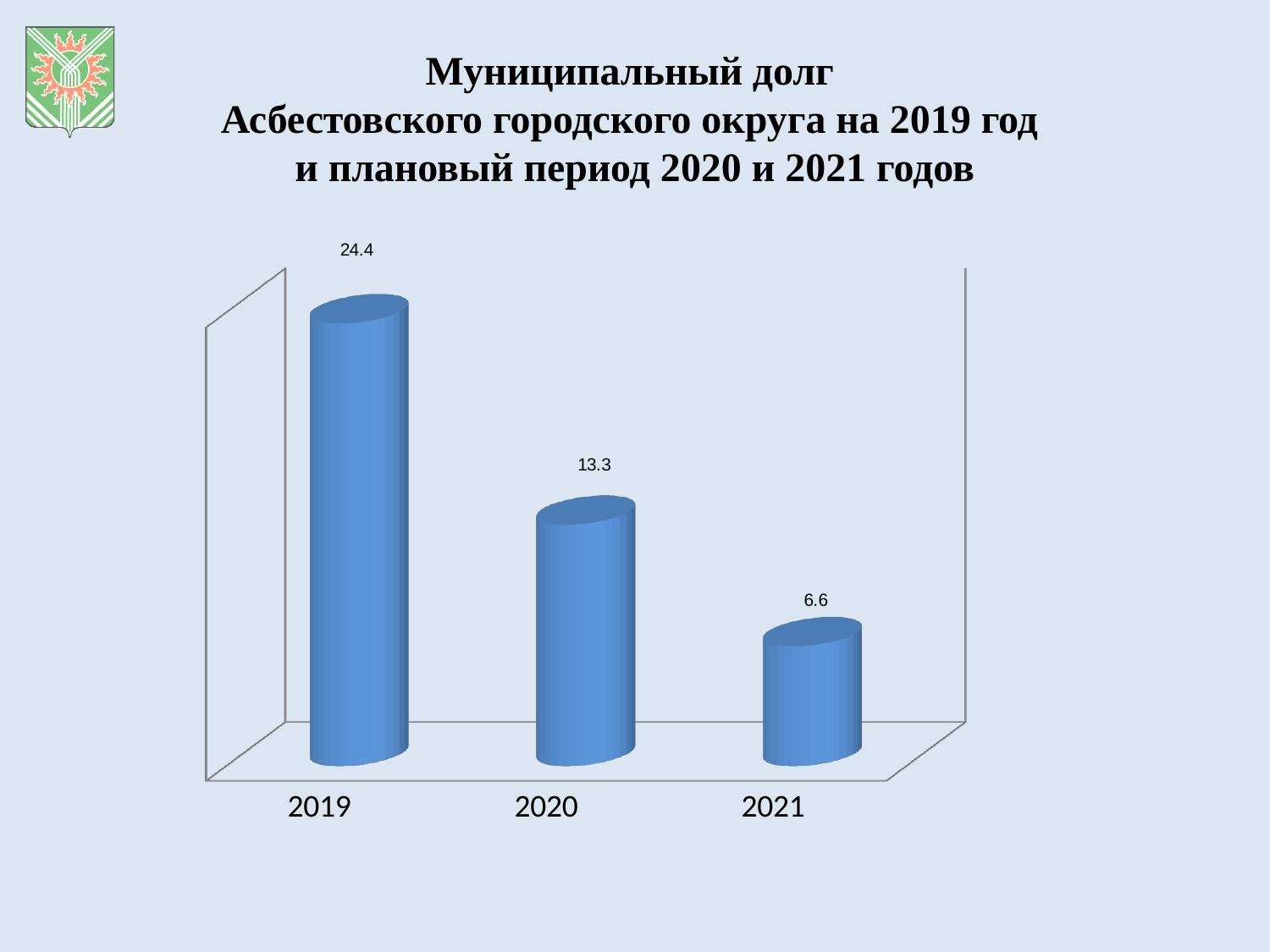
What is the value for 2021? 6.6 Which year has the lowest value? 2021 What is the value for 2019? 24.4 What is the title of the slide? Муниципальный долг Асбестовского городского округа на 2019 год и плановый период 2020 и 2021 годов What is the difference between the values for 2020 and 2021? 6.7 What is the value for 2020? 13.3 What kind of chart is shown on the slide? bar chart How many years are shown on the chart? 3 What is the difference between the values for 2019 and 2020? 11.1 Which year has the highest value? 2019 Which is larger, the value for 2020 or the value for 2021? 2020 Do the values rise or fall from 2019 to 2021? fall